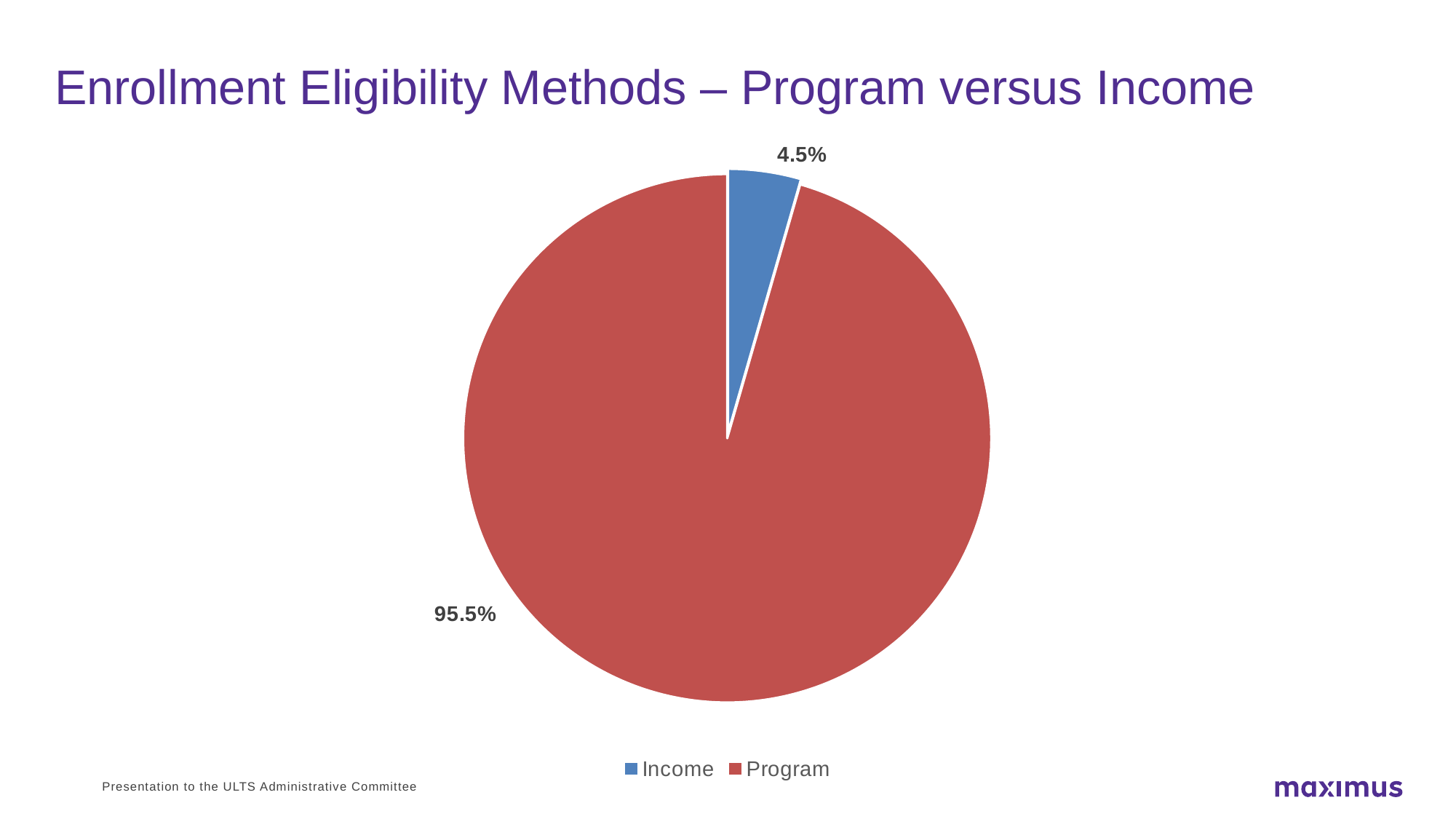
What kind of chart is shown on the slide? Pie chart Which is larger, the Income share or the Program share? Program How many slices does the pie chart have? 2 Which category has the smallest share of the pie? Income What share of the pie does Income represent? 4.5% How many entries does the legend list? 2 Which category has the largest share of the pie? Program What is the difference in percentage points between the Program share and the Income share? 91 percentage points What is the title of the slide containing the chart? Enrollment Eligibility Methods – Program versus Income What share of the pie does Program represent? 95.5% What colour is the Income slice? Blue What is the total of the two slice percentages shown? 100%